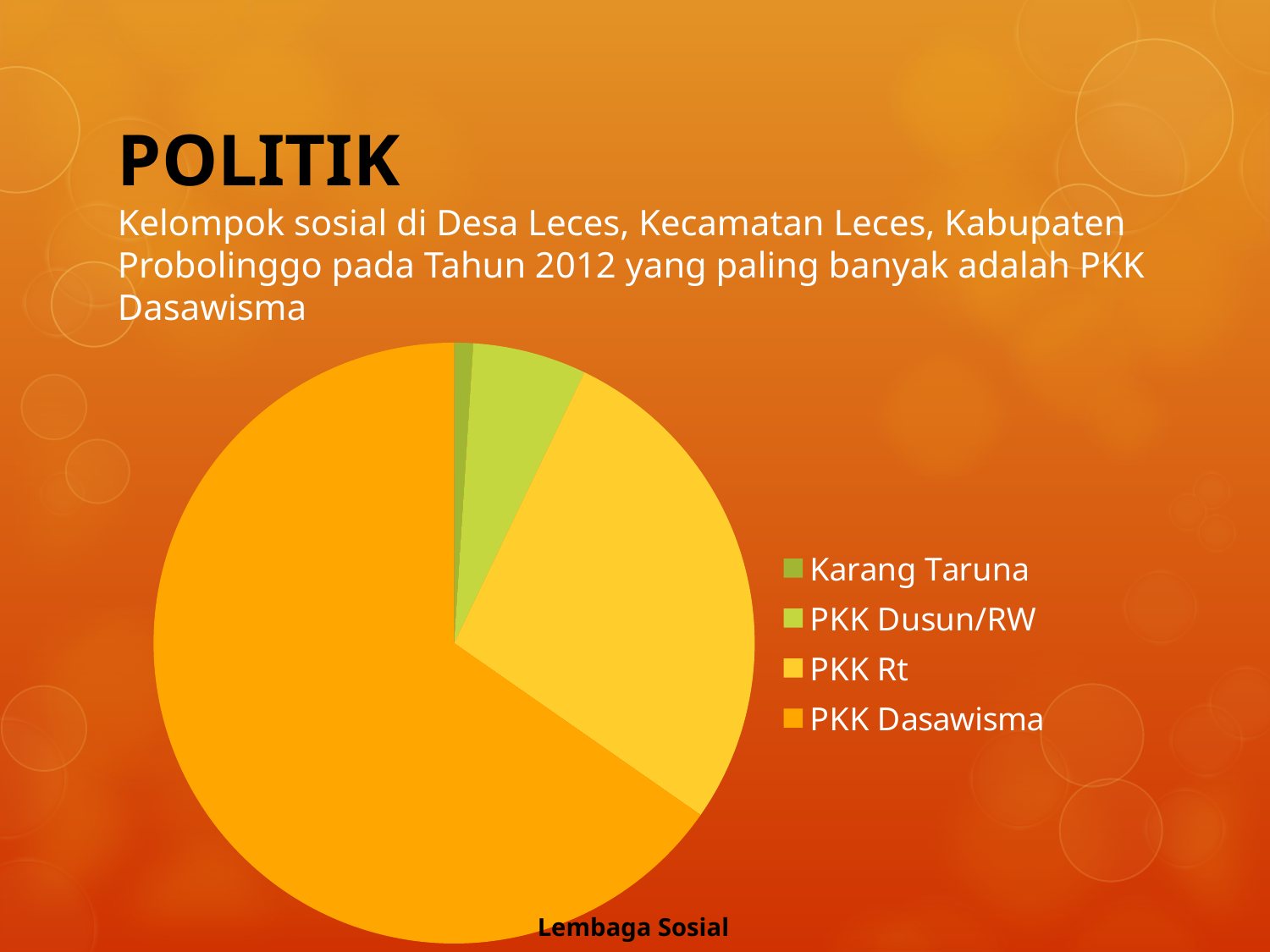
Which category has the largest slice of the pie? PKK Dasawisma Which slice is larger, PKK Rt or PKK Dusun/RW? PKK Rt How many categories does the pie chart have? 4 Which slice is larger, PKK Dasawisma or PKK Rt? PKK Dasawisma Which category has the second-largest slice of the pie? PKK Rt Which category has the smallest slice of the pie? Karang Taruna What is the title of the chart? Lembaga Sosial How many entries does the legend list? 4 What kind of chart is shown on the slide? pie chart Which category is shown in orange in the pie chart? PKK Dasawisma